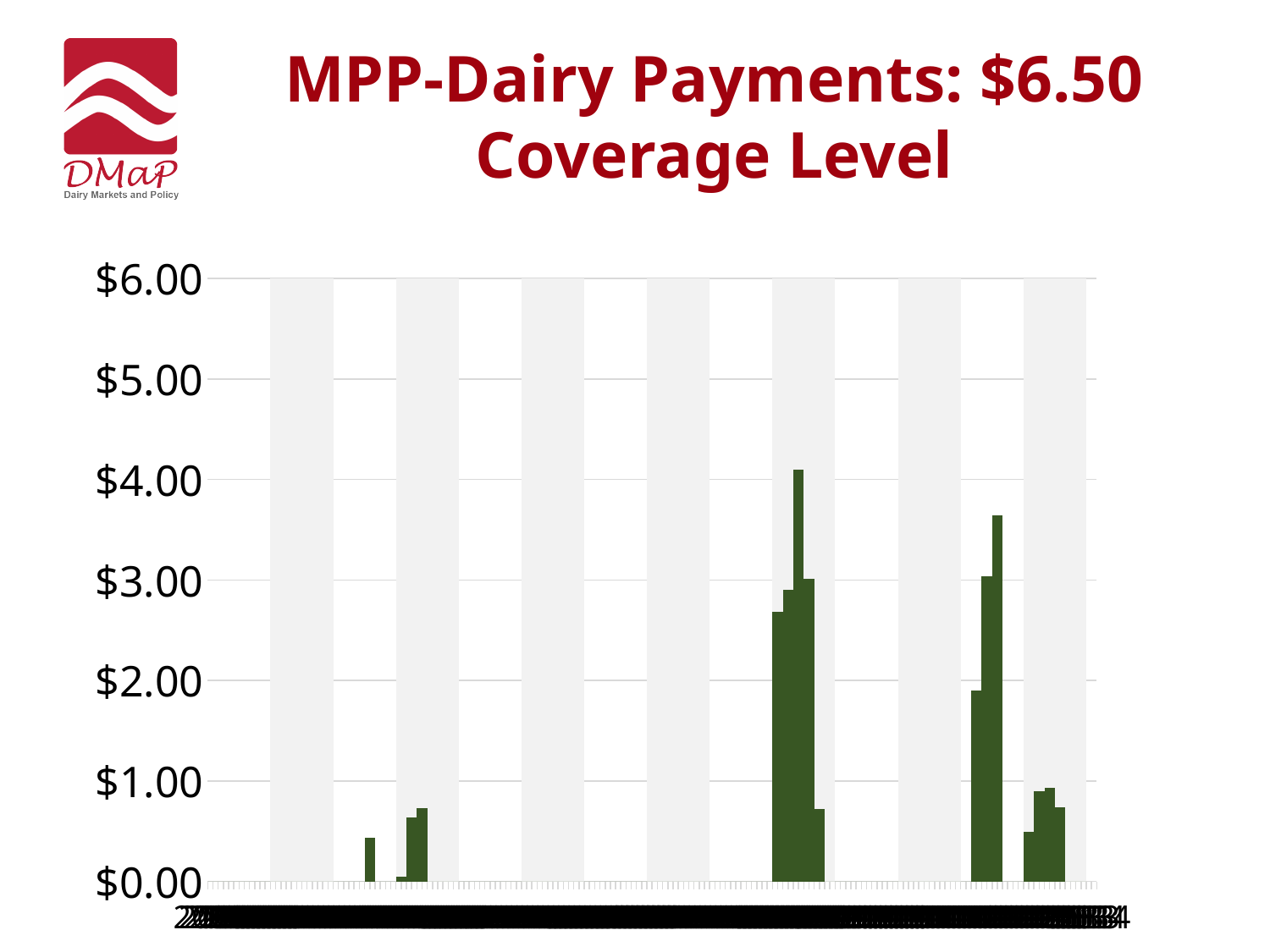
Does any bar in the chart exceed $5.00? No What is the title of the chart on the slide? MPP-Dairy Payments: $6.50 Coverage Level What is the highest value labelled on the vertical axis of the chart? $6.00 What kind of chart is shown on the slide? bar chart What is the lowest value labelled on the vertical axis of the chart? $0.00 What colour are the bars in the chart? dark green Does any bar in the chart reach the $6.00 gridline? No Is the tallest bar in the chart greater or less than $3.00? greater What is the interval between consecutive tick labels on the vertical axis? $1.00 How many tick labels are shown on the vertical axis of the chart? 7